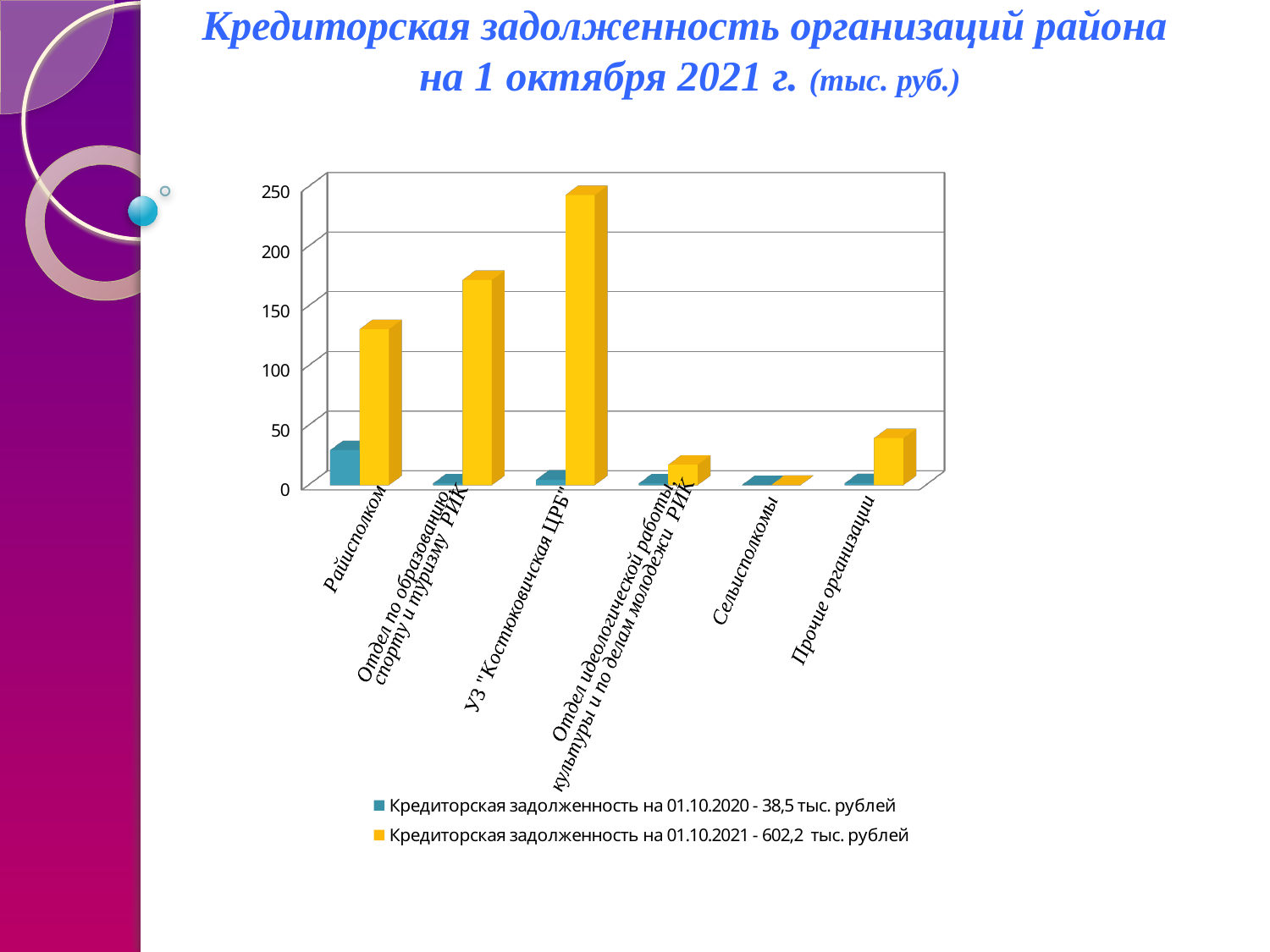
Is the value for Прочие организации in the series "Кредиторская задолженность на 01.10.2021" greater or less than 100? less What kind of chart is shown on the slide? bar chart According to the legend, what is the total creditor debt on 01.10.2021? 602,2 тыс. рублей How many series does the legend list? 2 Which category has the lowest value for the series "Кредиторская задолженность на 01.10.2021"? Сельисполкомы Which category has the highest value for the series "Кредиторская задолженность на 01.10.2020"? Райисполком How many categories are shown on the x axis of the chart? 6 Which is larger for the series "Кредиторская задолженность на 01.10.2021": Отдел по образованию, спорту и туризму РИК or Прочие организации? Отдел по образованию, спорту и туризму РИК Is the value for УЗ "Костюковичская ЦРБ" in the series "Кредиторская задолженность на 01.10.2021" greater or less than 200? greater Is the value for Райисполком in the series "Кредиторская задолженность на 01.10.2020" greater or less than 50? less Which category has the highest value for the series "Кредиторская задолженность на 01.10.2021"? УЗ "Костюковичская ЦРБ"